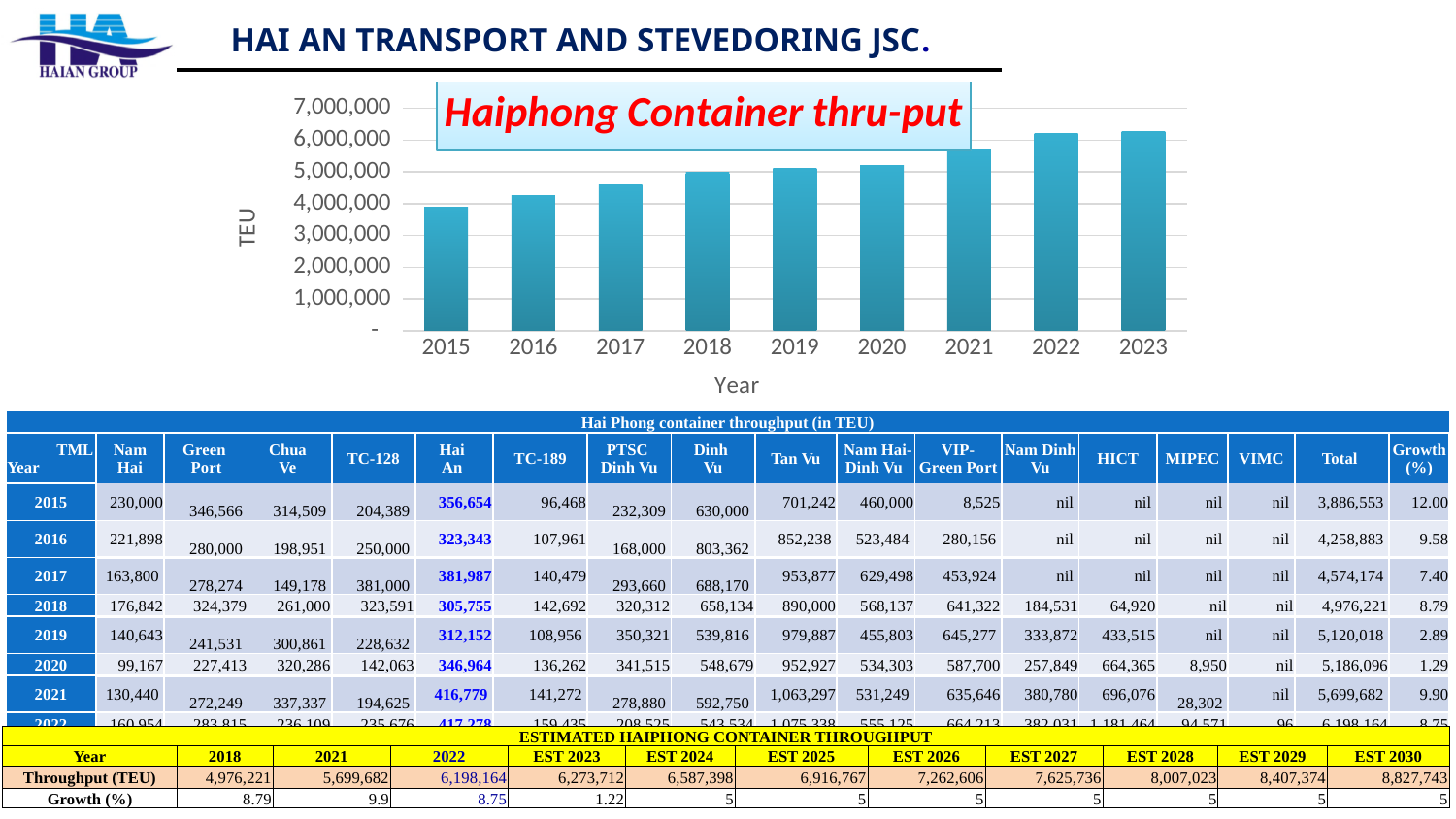
What kind of chart is the Haiphong Container thru-put chart? bar chart How many years are shown on the x axis of the Haiphong Container thru-put chart? 9 Do the bars in the Haiphong Container thru-put chart rise or fall from 2015 to 2023? rise In the Haiphong Container thru-put chart, is the value for 2016 greater or less than 4,000,000? greater Which year has the lowest bar in the Haiphong Container thru-put chart? 2015 In the Haiphong Container thru-put chart, which year has the larger value, 2016 or 2020? 2020 In the Haiphong Container thru-put chart, is the value for 2015 greater or less than 3,000,000? greater In the Haiphong Container thru-put chart, is the value for 2022 greater or less than 6,000,000? greater What is the title of the bar chart on the slide? Haiphong Container thru-put What is the label on the vertical axis of the Haiphong Container thru-put chart? TEU